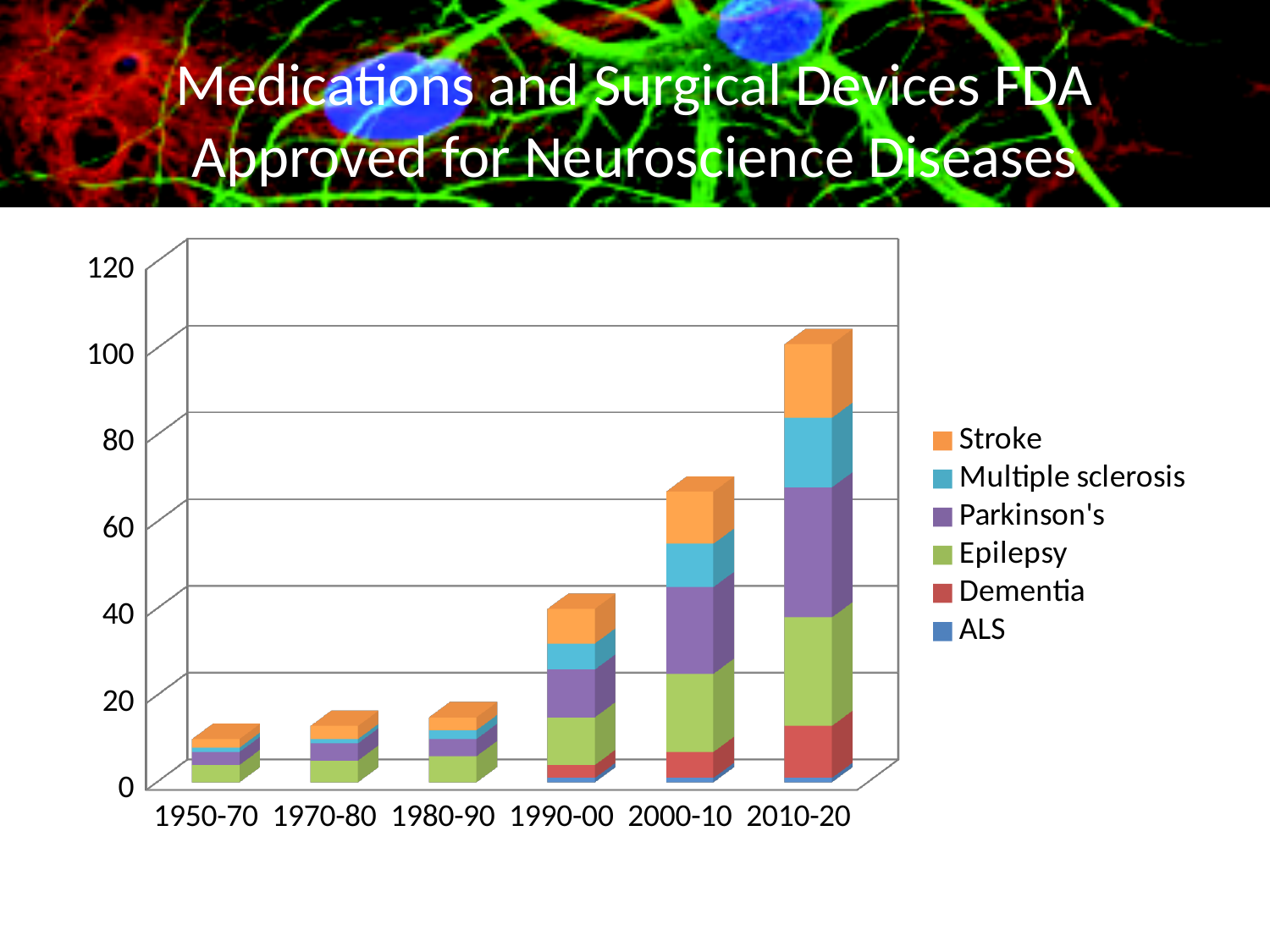
Is the total for 2000-10 greater or less than 40? greater How many series does the chart's legend list? 6 Which time period has the shortest stacked bar? 1950-70 Is the total for 1990-00 greater or less than 60? less Which series is shown in orange in the chart's legend? Stroke Is the total for 2010-20 greater or less than 80? greater Which time period has the tallest stacked bar? 2010-20 Do the stacked bar totals rise or fall from 1950-70 to 2010-20? rise What kind of chart is shown on the slide? stacked bar chart Which has the larger stacked bar total, 2000-10 or 2010-20? 2010-20 What is the title of the slide containing the chart? Medications and Surgical Devices FDA Approved for Neuroscience Diseases How many time periods are shown on the x axis of the chart? 6